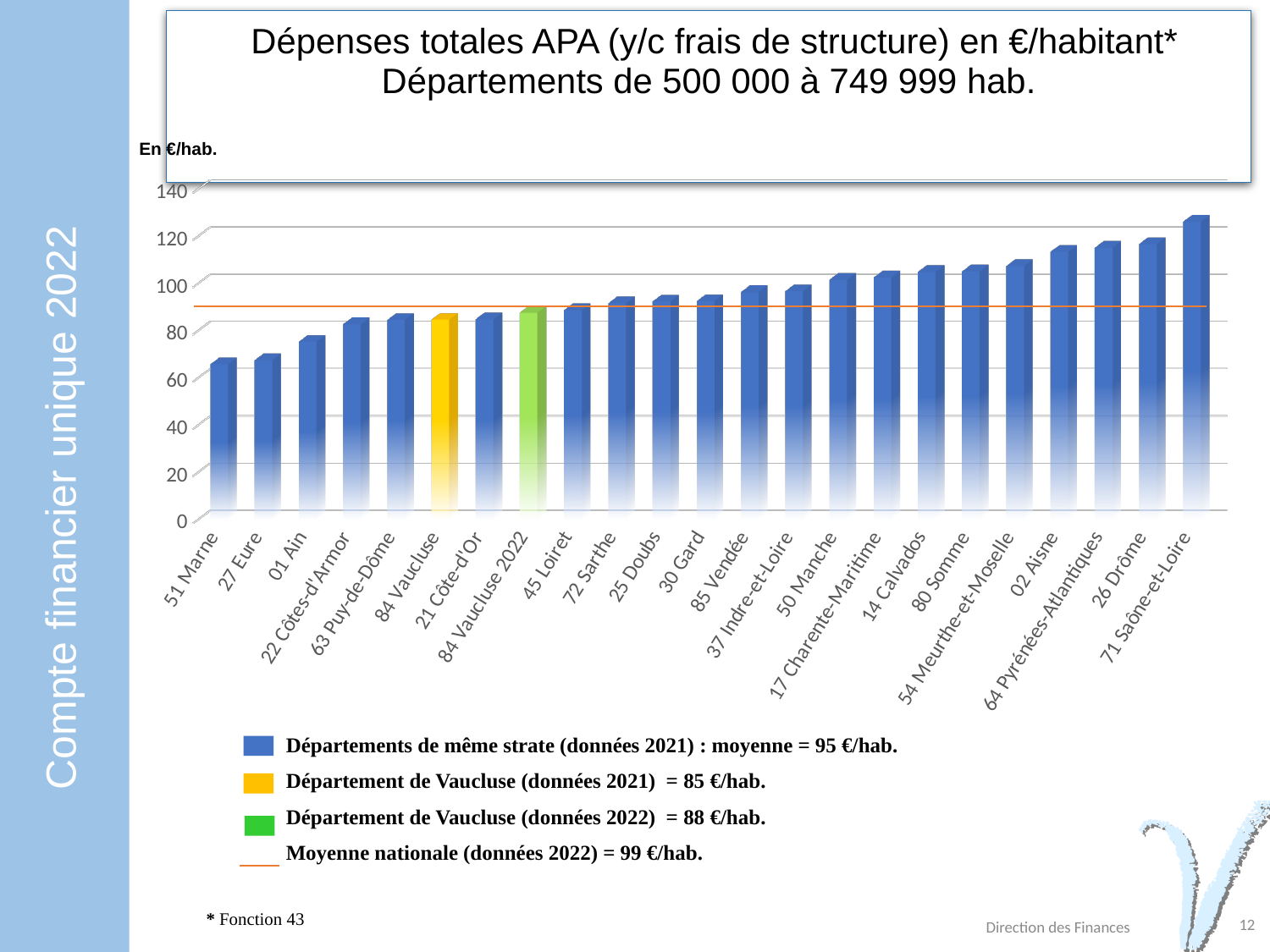
What is the difference between the Vaucluse 2022 value and the Vaucluse 2021 value? 3 €/hab. Is the value for 02 Aisne greater or less than 100? greater Is the value for 71 Saône-et-Loire greater or less than 120? greater How many departments (bars) are plotted in the chart? 23 Which is larger, the value for 27 Eure or the value for 26 Drôme? 26 Drôme Is the value for 51 Marne greater or less than 80? less Which department has the highest value in the chart? 71 Saône-et-Loire What kind of chart is shown on the slide? bar chart Which department has the lowest value in the chart? 51 Marne According to the legend, what is the Moyenne nationale (données 2022) shown by the orange line? 99 €/hab. According to the legend, what is the value for Département de Vaucluse (données 2021)? 85 €/hab. According to the legend, what is the value for Département de Vaucluse (données 2022)? 88 €/hab.